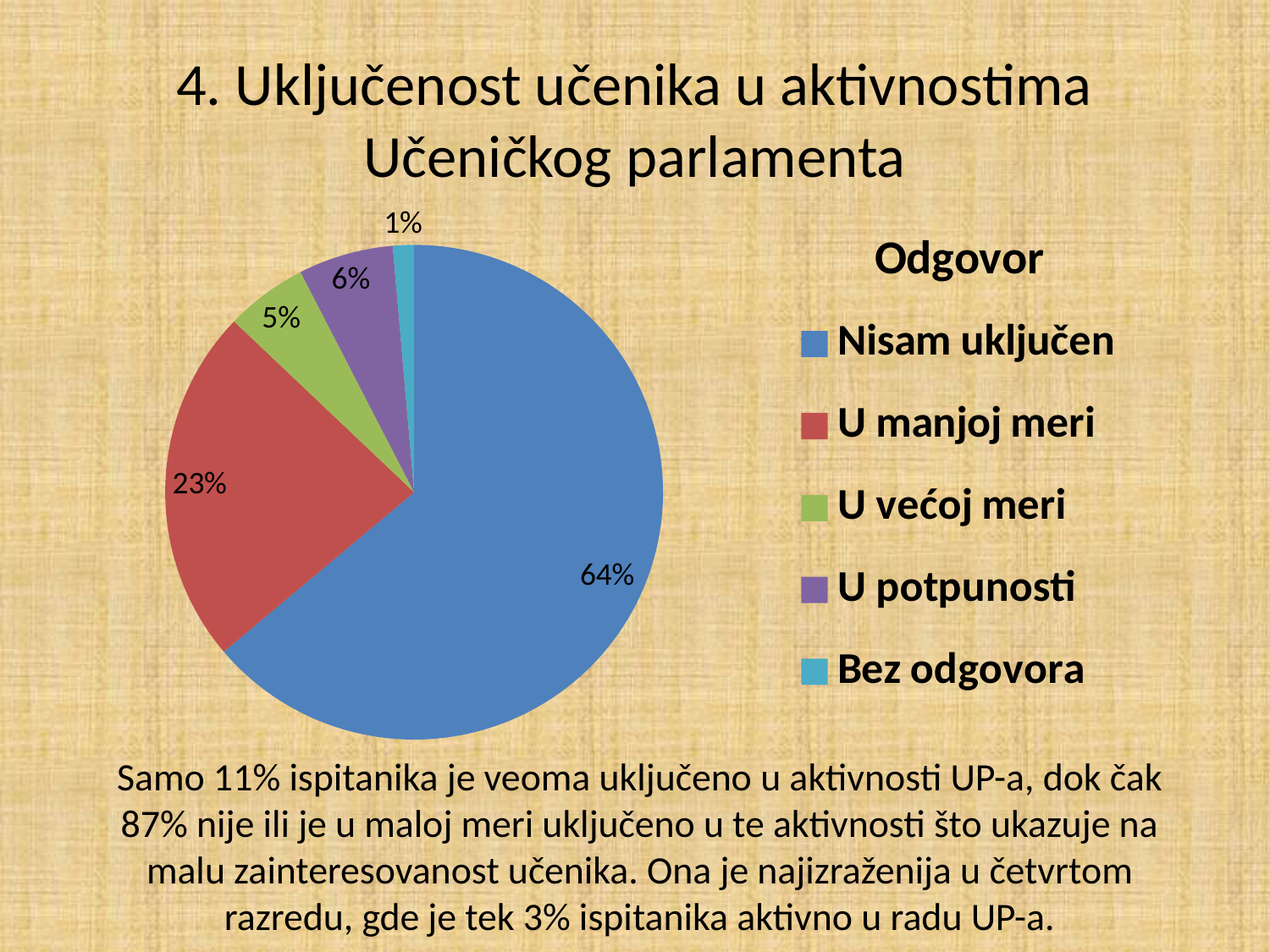
What share of the pie is labelled "U manjoj meri"? 23% What is the heading shown above the legend entries? Odgovor What share of the pie is labelled "U potpunosti"? 6% What share of the pie is labelled "Nisam uključen"? 64% How many categories does the pie chart have? 5 What is the difference in percentage points between "Nisam uključen" and "U manjoj meri"? 41 Which category has the largest slice of the pie? Nisam uključen Which is larger, the slice for "U potpunosti" or the slice for "U većoj meri"? U potpunosti Which category has the smallest slice of the pie? Bez odgovora What kind of chart is shown on the slide? pie chart